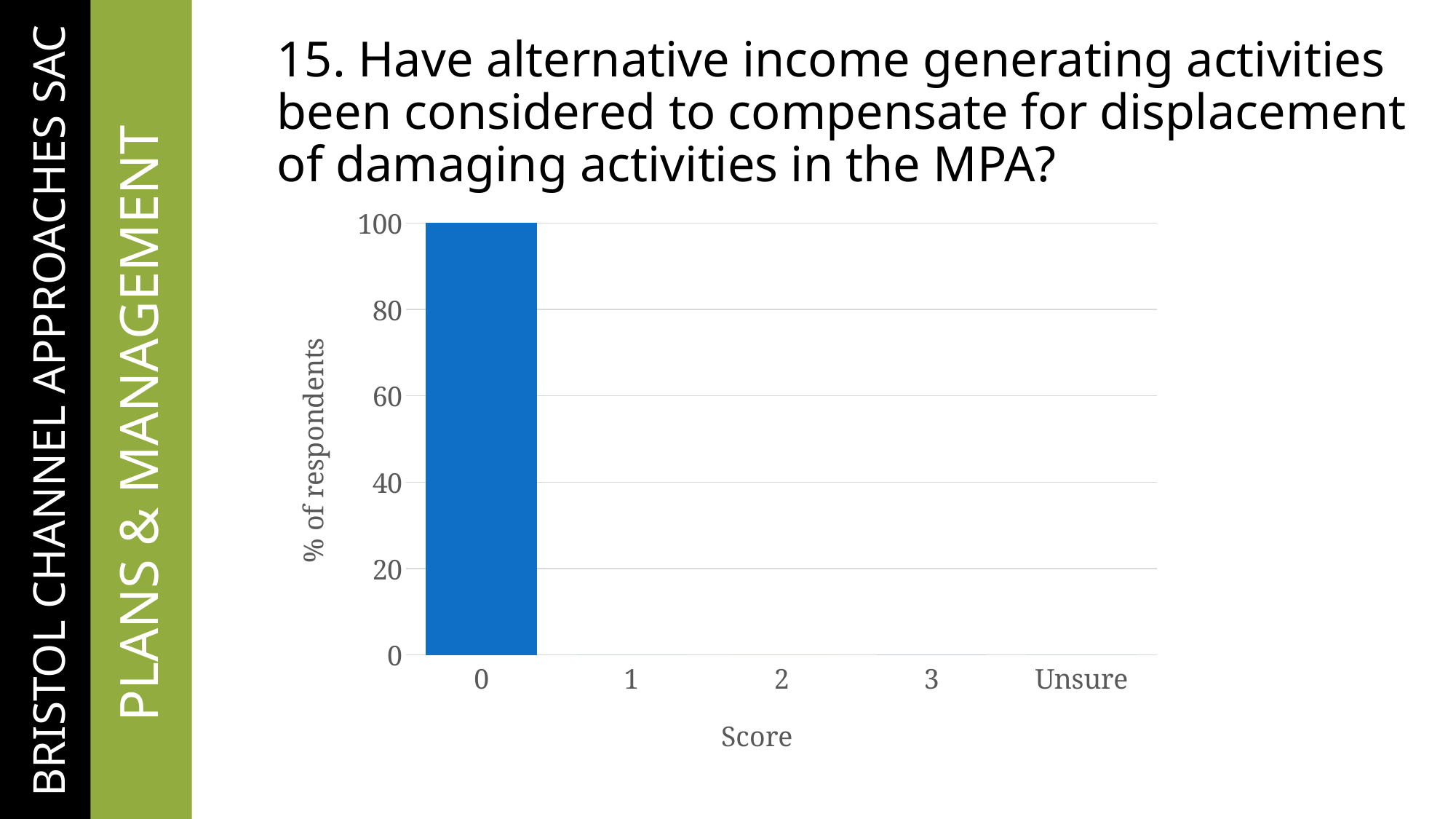
What kind of chart is shown on the slide? bar chart What is the percentage of respondents for score 0? 100 What is the difference between the value for score 0 and the value for score 3? 100 How many score categories have a visible bar in the chart? 1 Which score category has the highest percentage of respondents? 0 What is the label on the y axis of the chart? % of respondents Which has a larger value, score 0 or score 1? 0 What is the percentage of respondents for the Unsure category? 0 Is the value for score 0 greater or less than 80? greater How many categories are shown on the x axis of the chart? 5 What is the label on the x axis of the chart? Score Do the values rise or fall from score 0 to score 1? fall